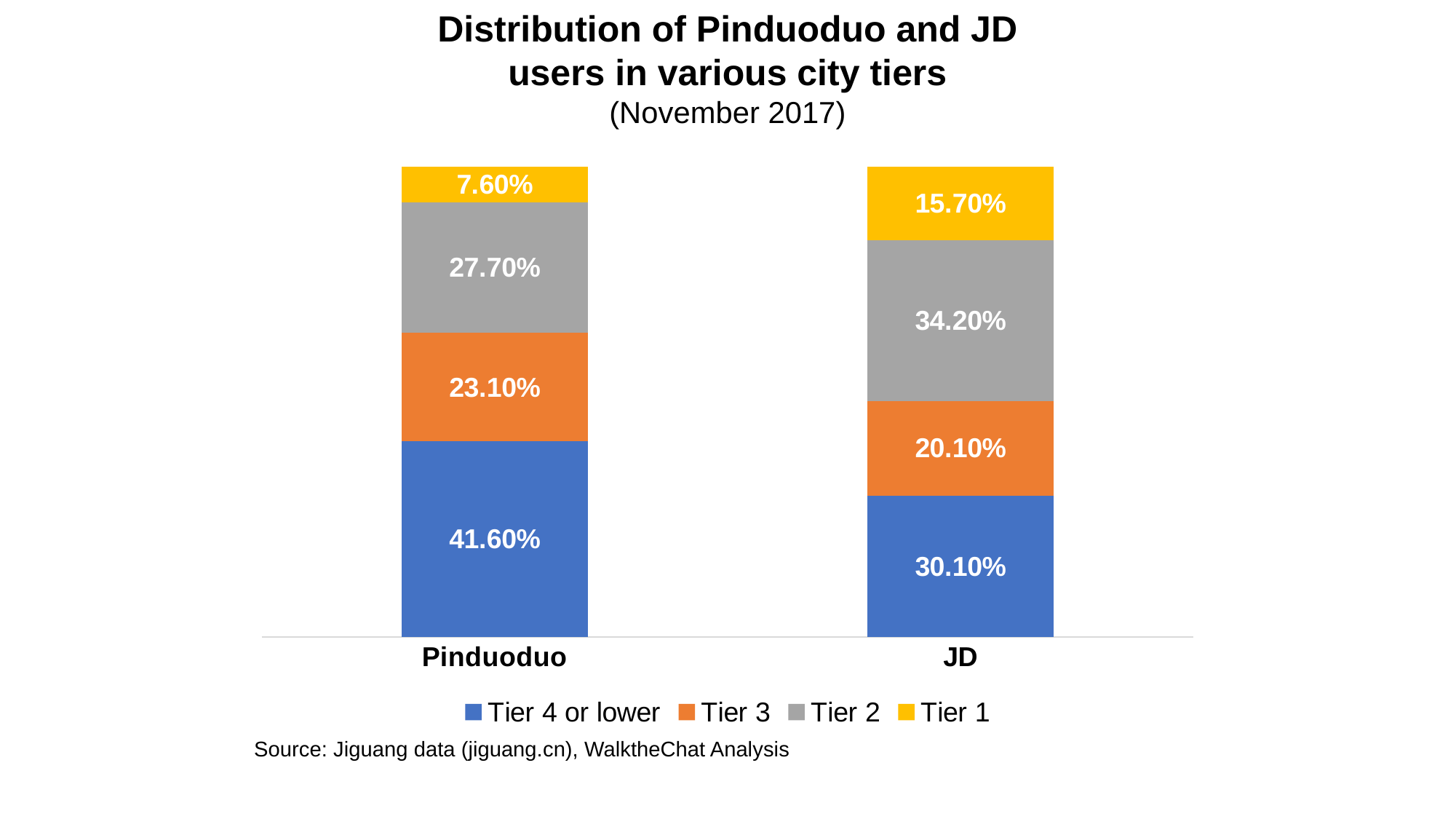
What share of JD users are in Tier 1 cities? 15.70% What is the Tier 2 value for JD? 34.20% What is the difference between the Tier 4 or lower shares of Pinduoduo and JD? 11.50% Which city tier has the largest share of Pinduoduo users? Tier 4 or lower How many series does the legend list? 4 What share of Pinduoduo users are in Tier 4 or lower cities? 41.60% What is the Tier 3 value for Pinduoduo? 23.10% Which city tier has the smallest share of JD users? Tier 1 What colour represents Tier 2 in the chart? Grey What kind of chart is shown? Stacked bar chart Which has a larger Tier 1 share, Pinduoduo or JD? JD How many companies are shown on the x axis? 2